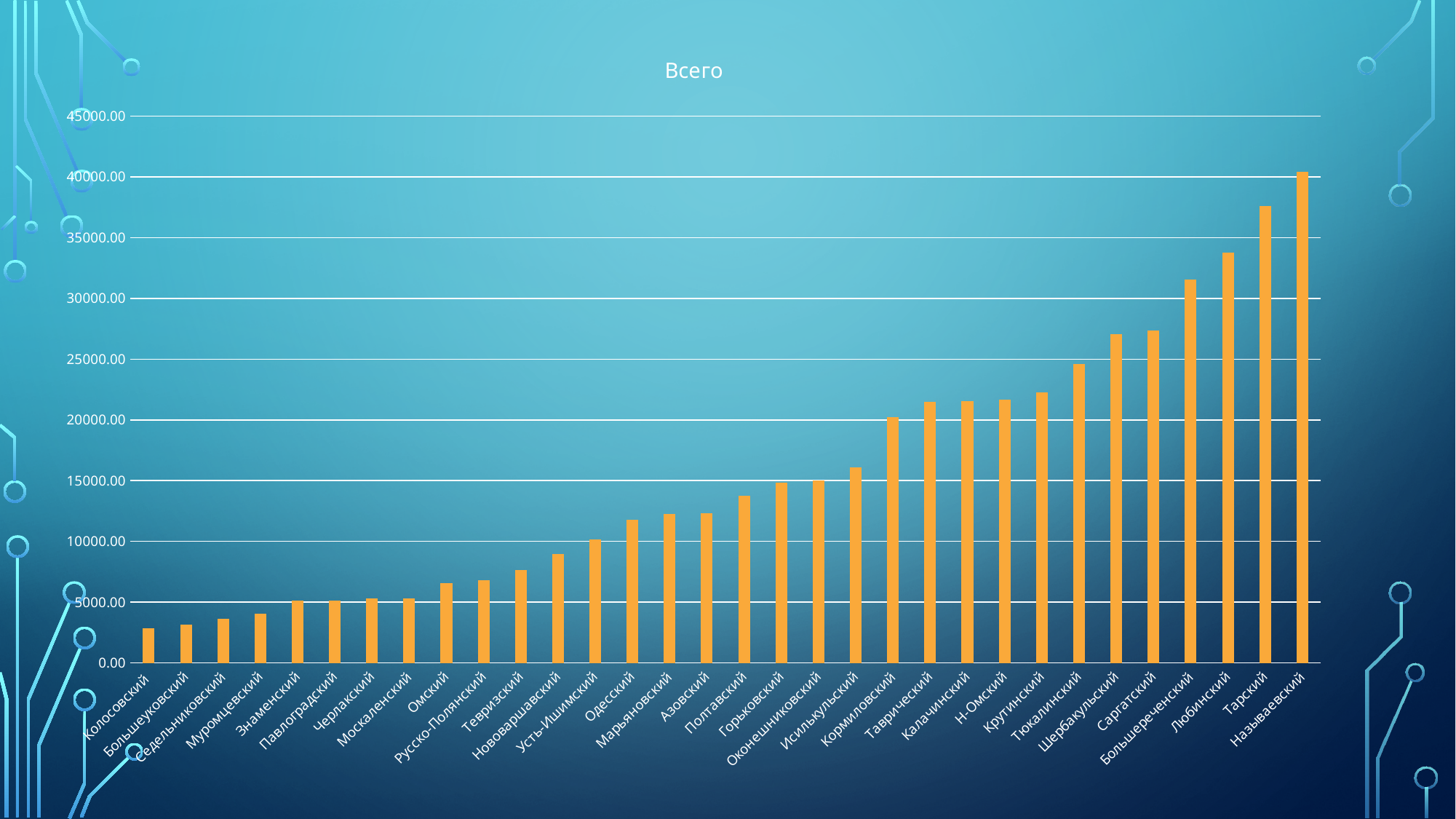
What is the title of the chart? Всего Which is larger, the value for Любинский or the value for Саргатский? Любинский What kind of chart is shown on the slide? bar chart Is the value for Колосовский greater or less than 5000.00? less How many categories are plotted on the chart? 32 Which category has the highest value? Называевский Which category has the lowest value? Колосовский Is the value for Тарский greater or less than 35000.00? greater Do the values generally rise or fall from left to right along the x axis? rise